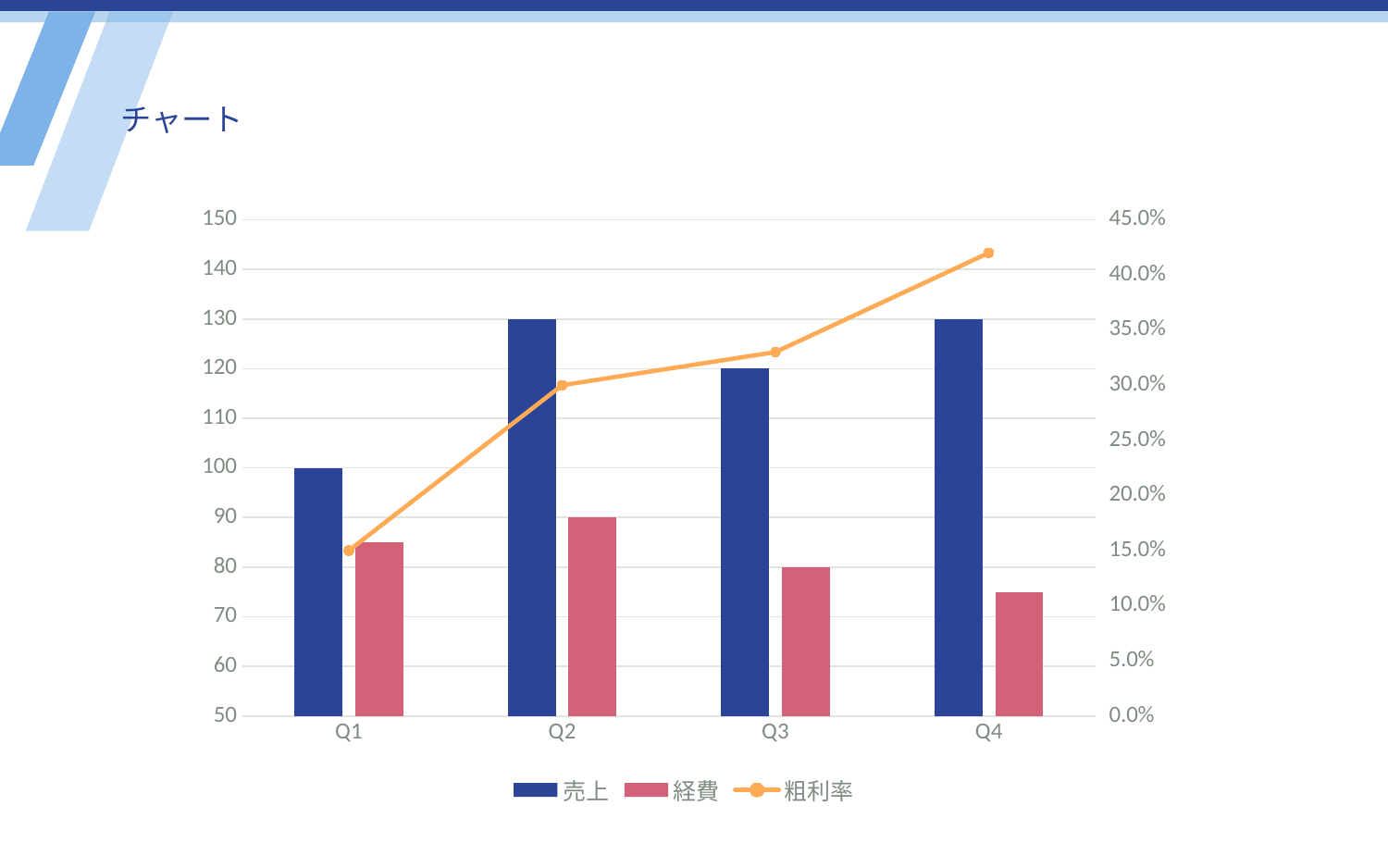
What kind of chart is shown on the slide? A combination bar and line chart What is the value of 売上 for Q1? 100 What is the value of 経費 for Q2? 90 What is the difference between 売上 in Q2 and 売上 in Q1? 30 How many series does the legend list? 3 How many categories are shown on the x axis? 4 Is the 粗利率 value for Q4 greater or less than 40.0%? greater What is the value of 売上 for Q3? 120 Which quarter has the highest 経費? Q2 Which quarter has the lowest 売上? Q1 Does the 粗利率 line rise or fall from Q1 to Q4? It rises Which quarter has the lowest 経費? Q4